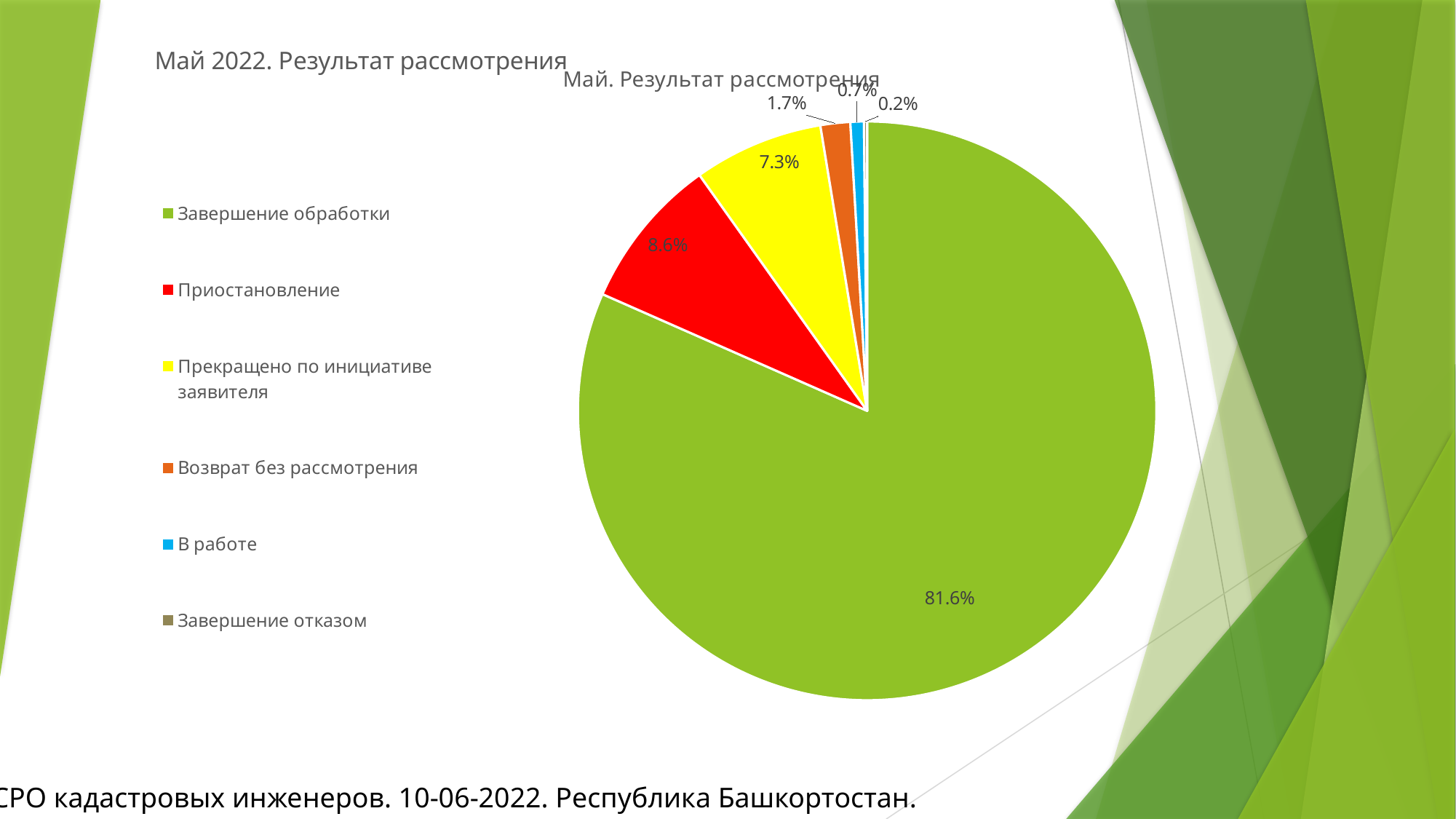
What share of the pie does "В работе" take? 0.7% What share of the pie does "Завершение обработки" take? 81.6% Which category has the largest slice of the pie? Завершение обработки What is the title of the chart? Май. Результат рассмотрения What share of the pie does "Приостановление" take? 8.6% What kind of chart is shown on the slide? pie chart Which is larger: the slice for "Приостановление" or the slice for "Прекращено по инициативе заявителя"? Приостановление What is the difference in percentage points between the "Приостановление" slice and the "Прекращено по инициативе заявителя" slice? 1.3% Which category has the smallest slice of the pie? Завершение отказом How many categories does the legend of the pie chart list? 6